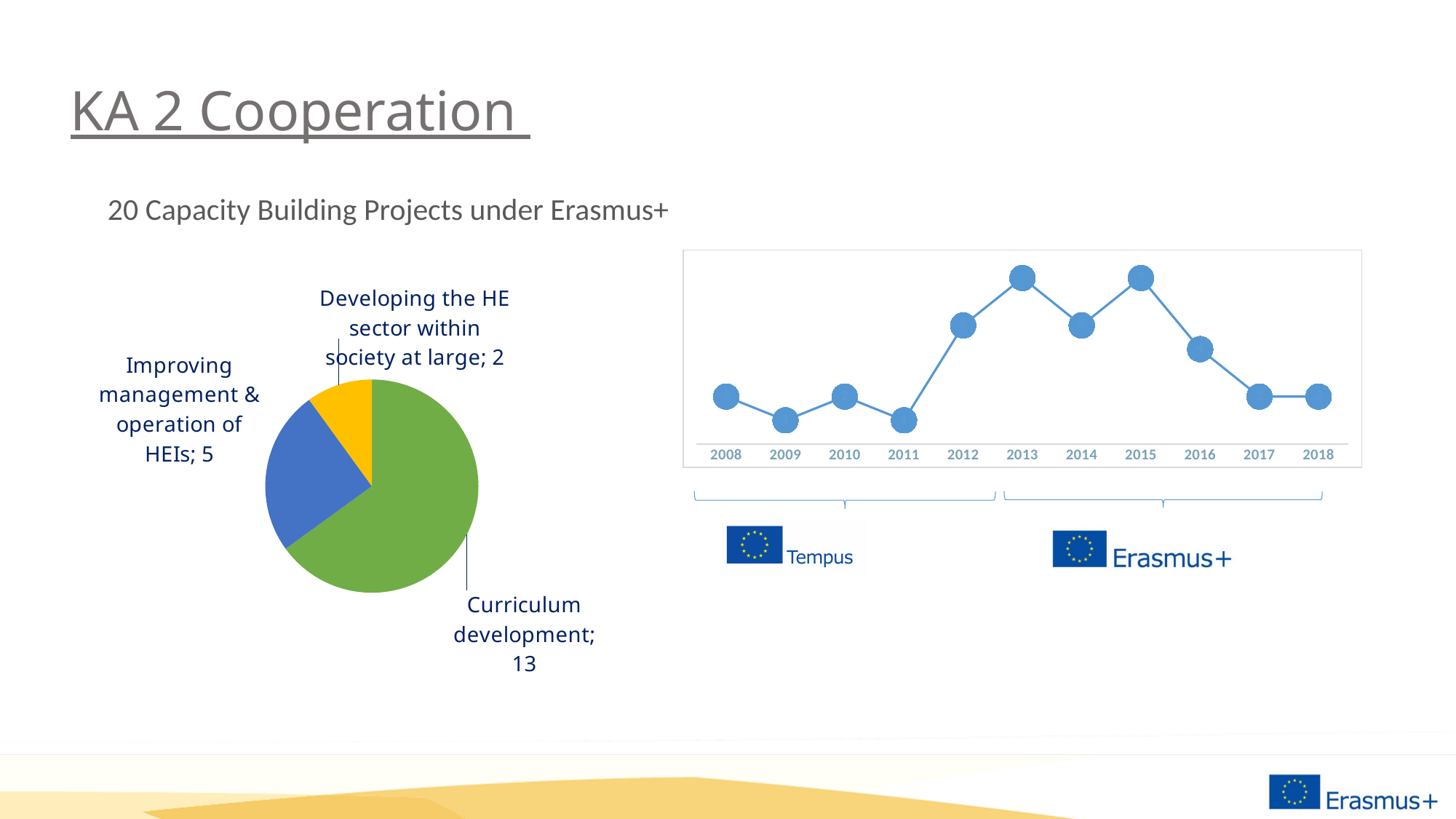
In the pie chart on the left, what share of the 20 projects does Curriculum development represent? 65% In the pie chart on the left, what colour is the Curriculum development slice? Green In the pie chart on the left, which category has the smallest slice? Developing the HE sector within society at large In the line chart on the right, is the value for 2013 larger or smaller than the value for 2008? Larger In the pie chart on the left, how many projects are for Improving management & operation of HEIs? 5 In the pie chart on the left, how many projects are for Curriculum development? 13 In the pie chart on the left, what is the difference between the number of Curriculum development projects and the number of Improving management & operation of HEIs projects? 8 In the line chart on the right, how many years are plotted on the x axis? 11 In the pie chart on the left, how many projects are for Developing the HE sector within society at large? 2 In the pie chart on the left, how many categories are shown? 3 What kind of chart is shown on the right of the slide? Line chart In the pie chart on the left, which category has the largest slice? Curriculum development